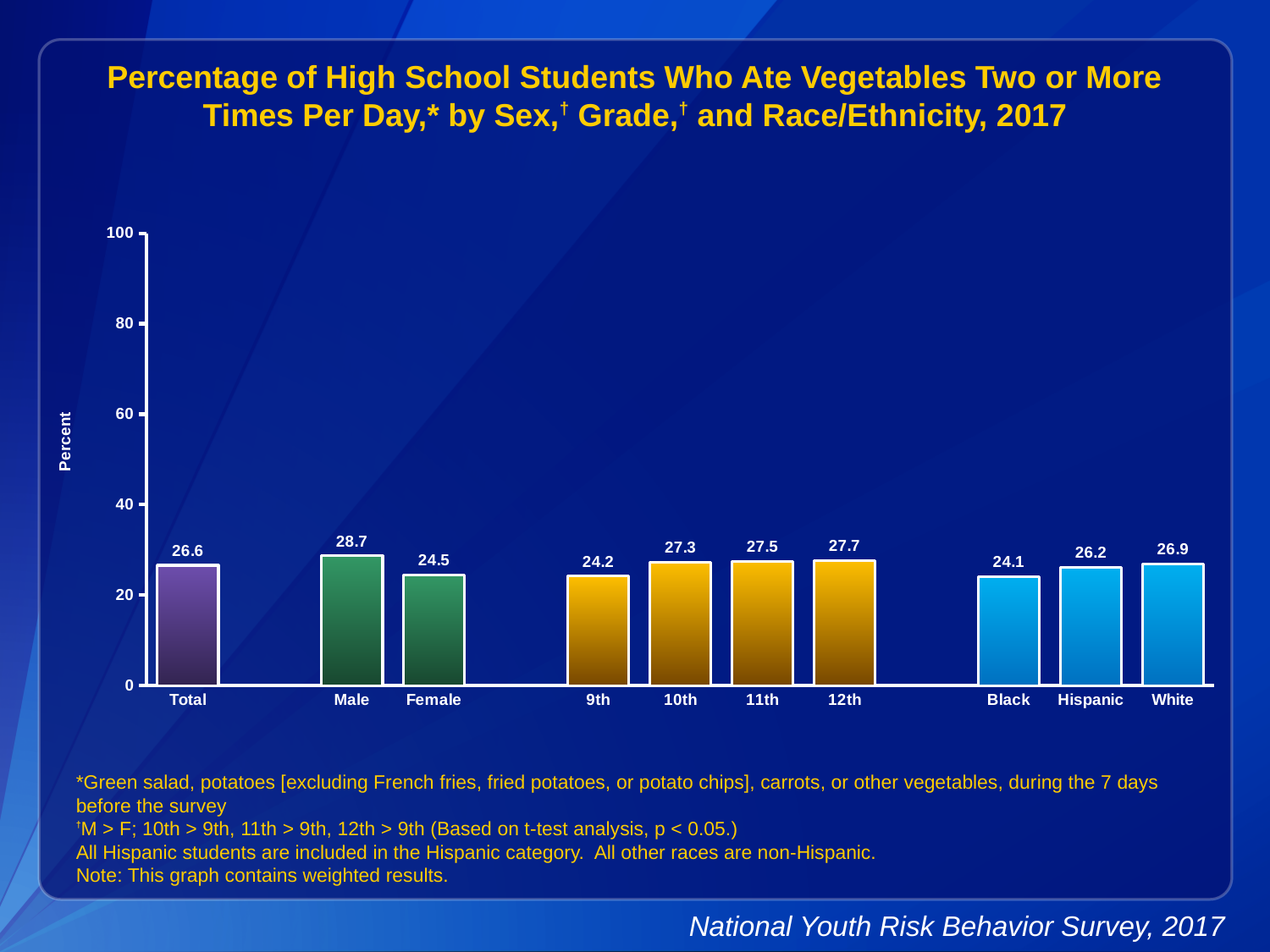
What is the difference between the 12th grade and 9th grade values? 3.5 Is the value for Total greater or less than 40? less What is the value for 9th grade? 24.2 What is the value for Male? 28.7 Which category has the lowest value? Black How many bars are shown in the chart? 10 What is the difference between the Male and Female values? 4.2 What kind of chart is this? bar chart Which category has the highest value? Male What is the value for Hispanic students? 26.2 Which is larger, the value for White or the value for Black? White What is the label of the y axis? Percent